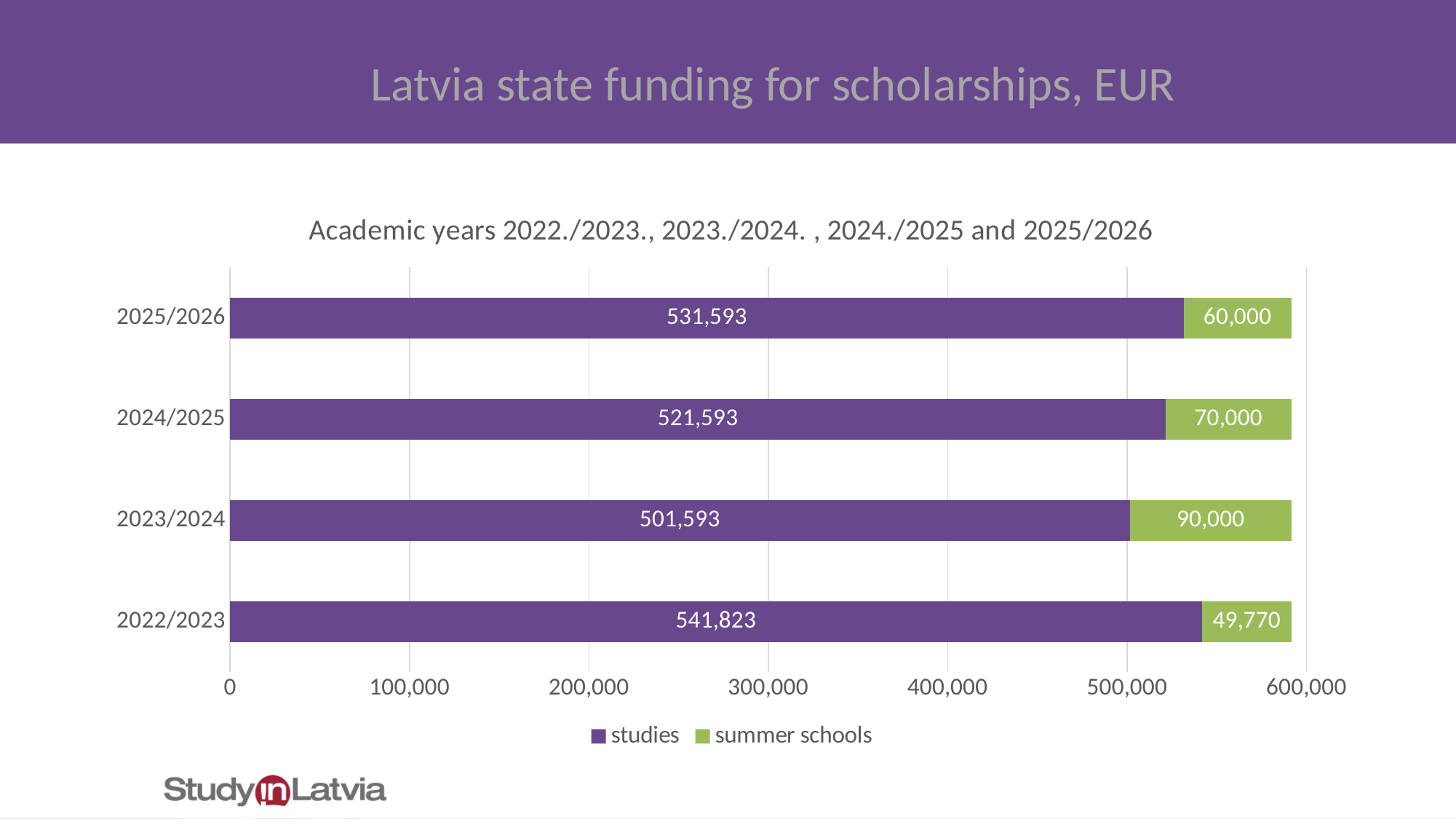
How many academic years are shown in the chart? 4 What is the difference in studies funding between 2025/2026 and 2024/2025? 10,000 What is the summer schools funding for 2023/2024? 90,000 What type of chart is shown on the slide? Stacked bar chart Which academic year has the highest studies funding? 2022/2023 What is the total funding (studies plus summer schools) for 2024/2025? 591,593 Which academic year has the lowest summer schools funding? 2022/2023 What is the studies funding for 2025/2026? 531,593 What is the summer schools funding for 2022/2023? 49,770 Which academic year has the highest summer schools funding? 2023/2024 How many series does the legend list? 2 Is the studies funding larger in 2022/2023 or in 2023/2024? 2022/2023